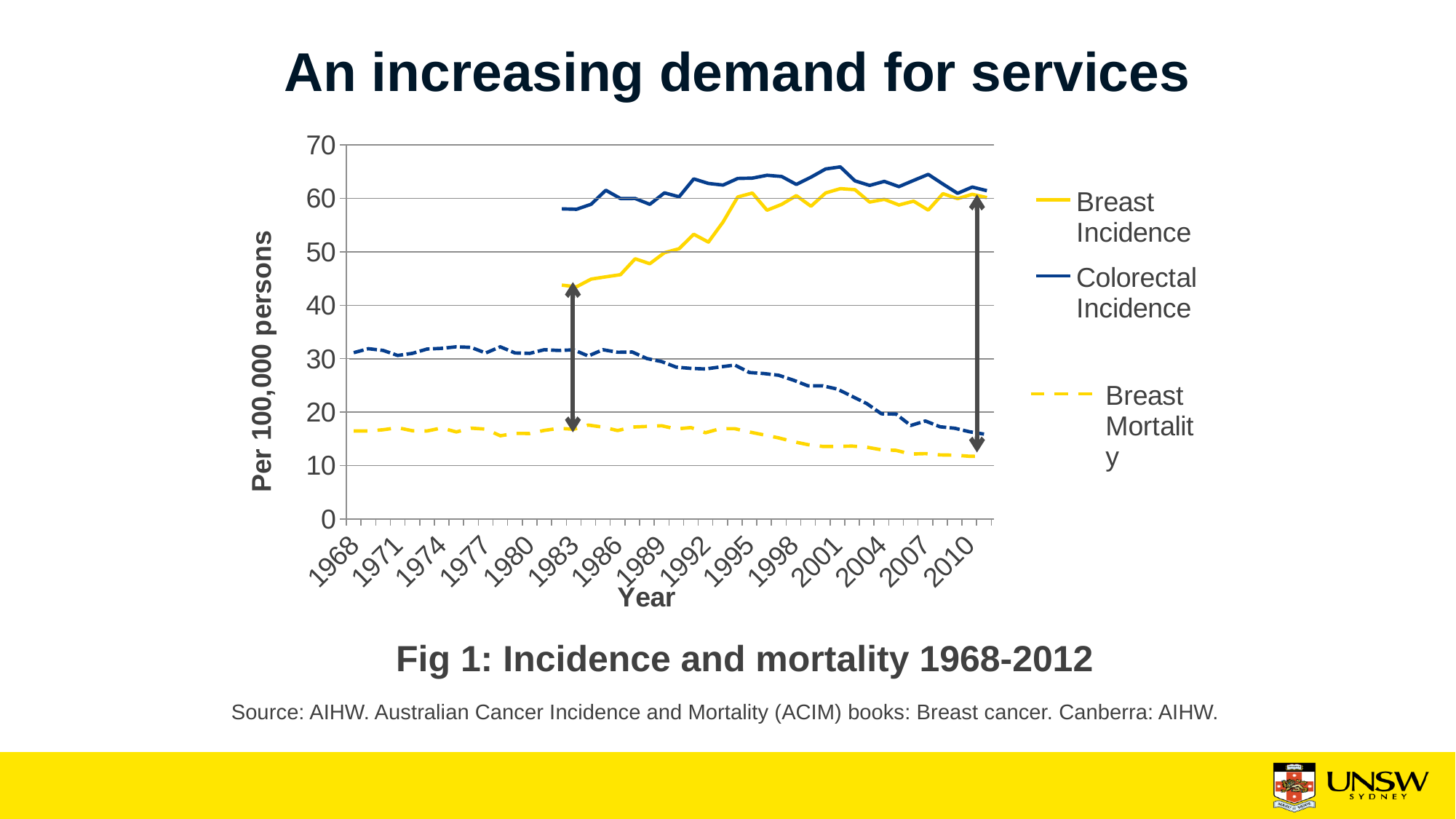
In 1983, which is higher: Colorectal Incidence or Breast Incidence? Colorectal Incidence Is the value for Breast Incidence in 1995 greater or less than 50? greater Is the value for Breast Mortality in 2010 greater or less than 20? less Which series has the highest value in 2001? Colorectal Incidence How many series does the chart legend list? 3 Does the Breast Mortality line rise or fall from 1968 to 2010? Fall Is the value for Breast Incidence in 1983 greater or less than 40? greater Does the Breast Incidence line rise or fall from 1983 to 2010? Rise What is the label on the y axis of the chart? Per 100,000 persons How many year labels are shown along the x axis? 15 What kind of chart is shown on the slide? Line chart